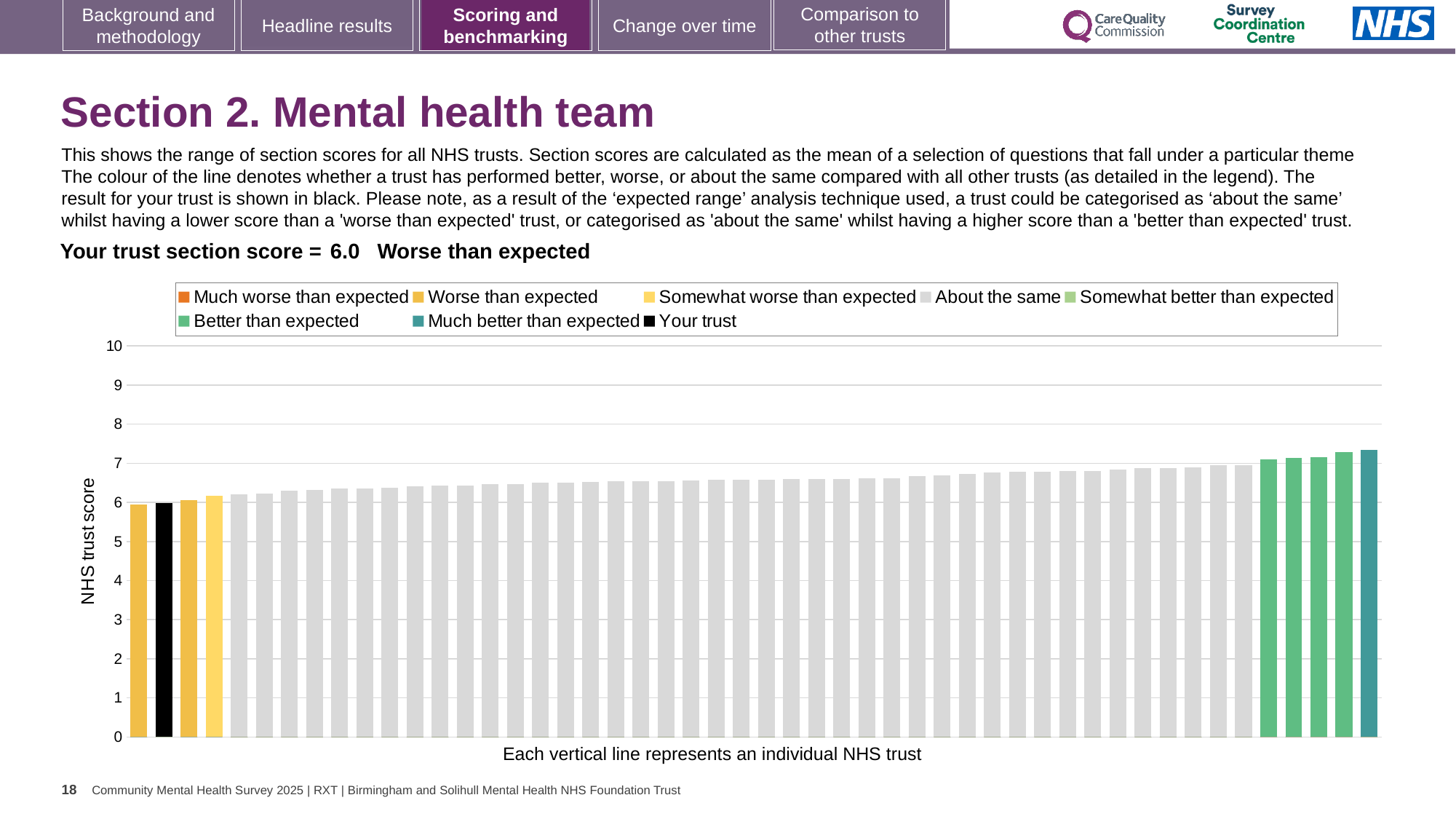
How many bars are coloured as 'Better than expected'? 4 What colour is the bar representing your trust? black Is the value for your trust's bar greater or less than 5? greater What is the section score for your trust? 6.0 How many entries does the chart legend list? 8 Is the value for your trust's bar greater or less than 7? less Which performance category does the highest-scoring trust fall into, according to its bar colour? Much better than expected Do the bar values rise or fall moving from left to right along the x axis? rise Is the value of the rightmost (highest) bar greater or less than 7? greater What is the label on the vertical axis of the chart? NHS trust score What kind of chart is shown on the slide? bar chart Which performance category is your trust placed in for this section? Worse than expected